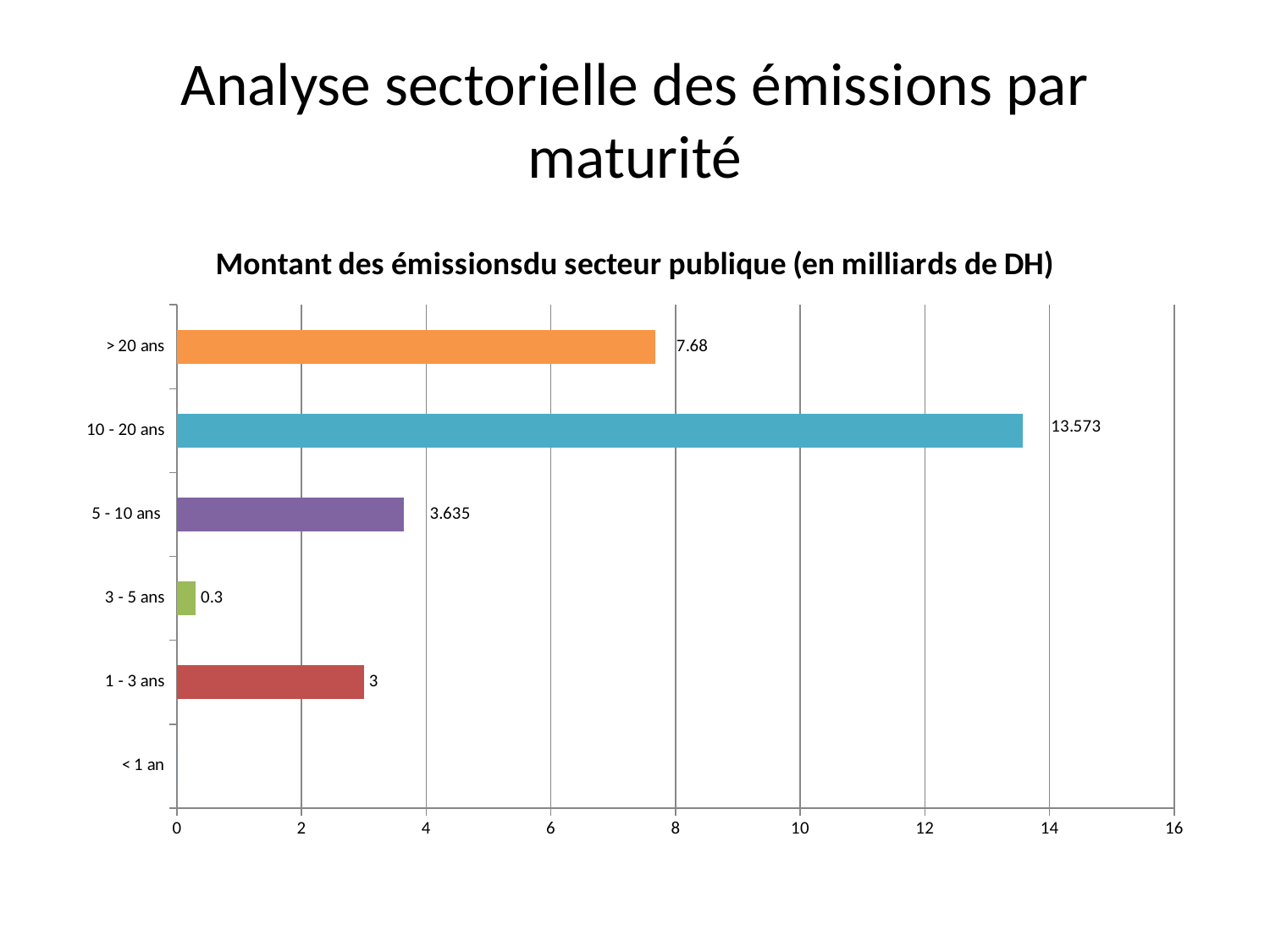
Is the value for > 20 ans greater or less than 8? less What is the difference between the values for 10 - 20 ans and > 20 ans? 5.893 What is the value for the 10 - 20 ans category? 13.573 How many maturity categories are shown on the y axis? 6 Which maturity category has the highest value? 10 - 20 ans Which is larger, the value for 5 - 10 ans or the value for 1 - 3 ans? 5 - 10 ans What is the title of the chart? Montant des émissionsdu secteur publique (en milliards de DH) What kind of chart is shown on the slide? bar chart Which maturity category with a visible bar has the lowest value? 3 - 5 ans What is the value for the 5 - 10 ans category? 3.635 What is the value for the 3 - 5 ans category? 0.3 What is the value for the > 20 ans category? 7.68